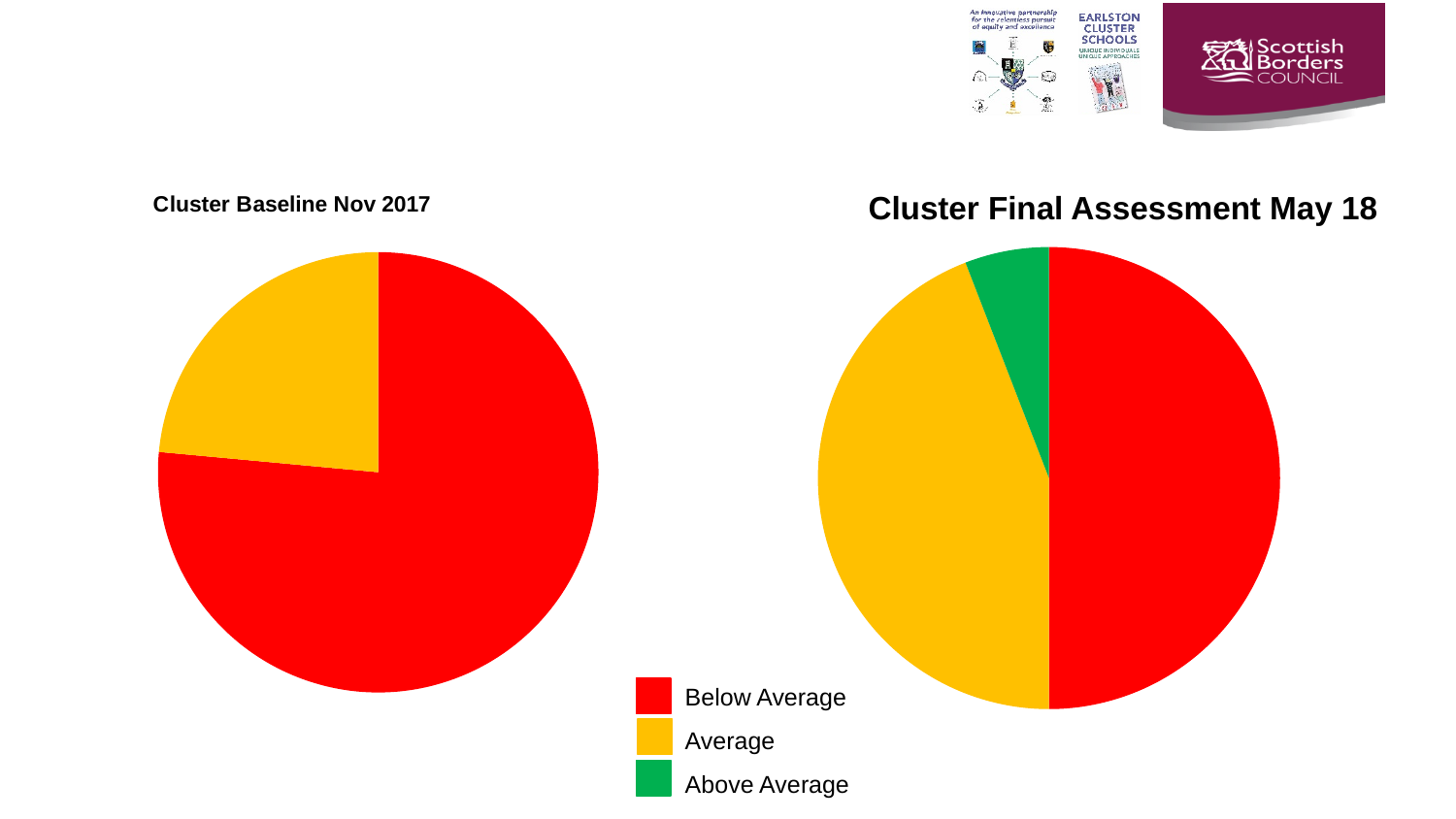
In the "Cluster Final Assessment May 18" chart, which category has the largest slice? Below Average In the "Cluster Final Assessment May 18" chart, which category has the smallest slice? Above Average In the "Cluster Baseline Nov 2017" chart, which category has the smallest slice? Average In the "Cluster Baseline Nov 2017" chart, which category has the largest slice? Below Average What kind of chart is the "Cluster Baseline Nov 2017" chart? pie chart In the "Cluster Final Assessment May 18" chart, which slice is larger: Average or Above Average? Average How many slices are shown in the "Cluster Final Assessment May 18" pie chart? 3 What kind of chart is the "Cluster Final Assessment May 18" chart? pie chart How many categories does the legend list? 3 In the "Cluster Baseline Nov 2017" chart, which slice is larger: Below Average or Average? Below Average Which colour represents Above Average in the legend? green How many slices are shown in the "Cluster Baseline Nov 2017" pie chart? 2